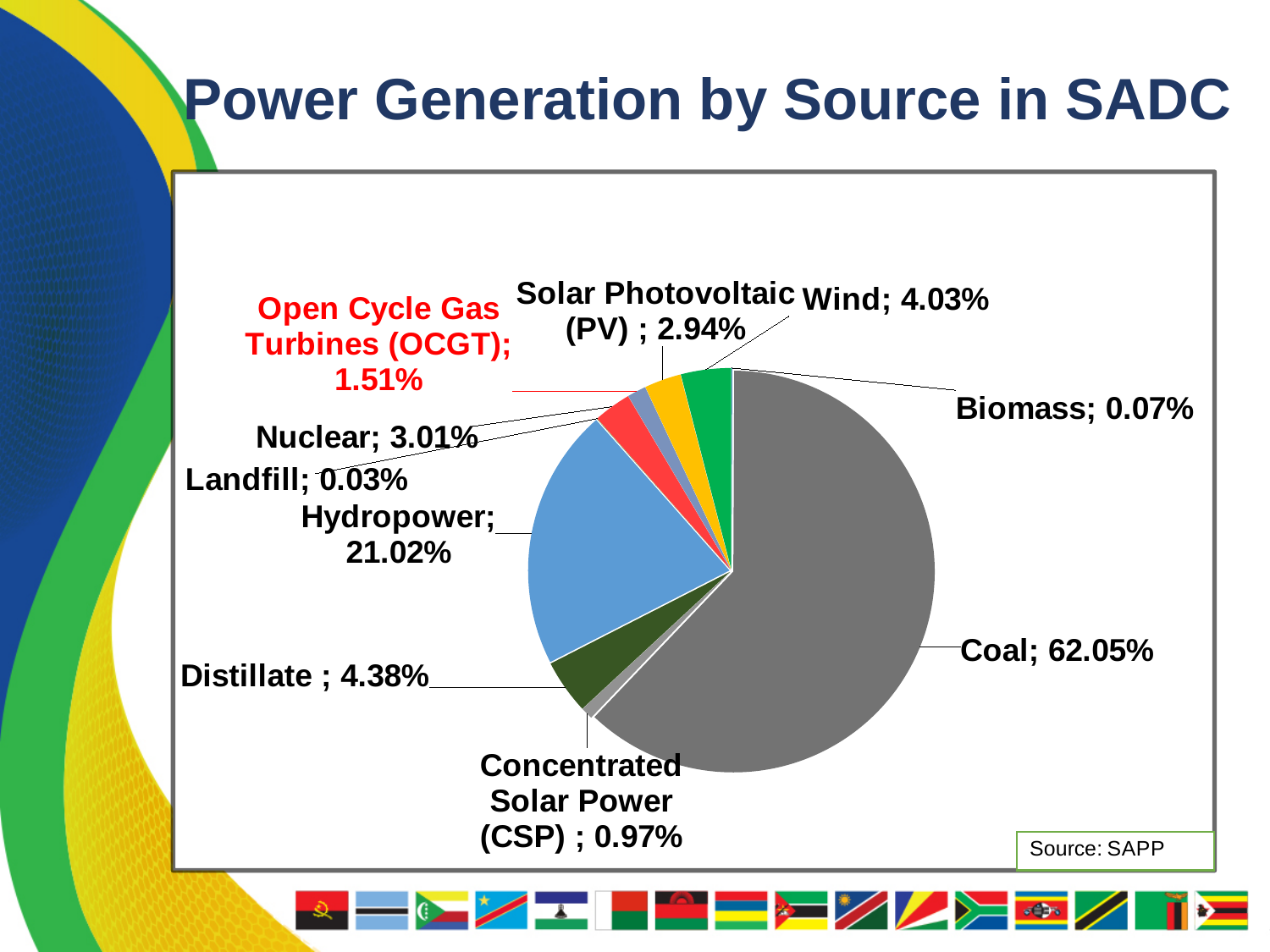
Which source has the smallest share of power generation? Landfill What is the difference between the shares of Coal and Hydropower? 41.03% What is the value shown for Concentrated Solar Power (CSP)? 0.97% Which source has the largest share of power generation? Coal How many sources are shown in the pie chart? 10 What is the title of the chart? Power Generation by Source in SADC What kind of chart is shown on the slide? Pie chart What share of power generation comes from Coal? 62.05% What share of power generation comes from Hydropower? 21.02% What is the value shown for Open Cycle Gas Turbines (OCGT)? 1.51% Which has a larger share, Wind or Nuclear? Wind What is the combined share of Wind and Solar Photovoltaic (PV)? 6.97%